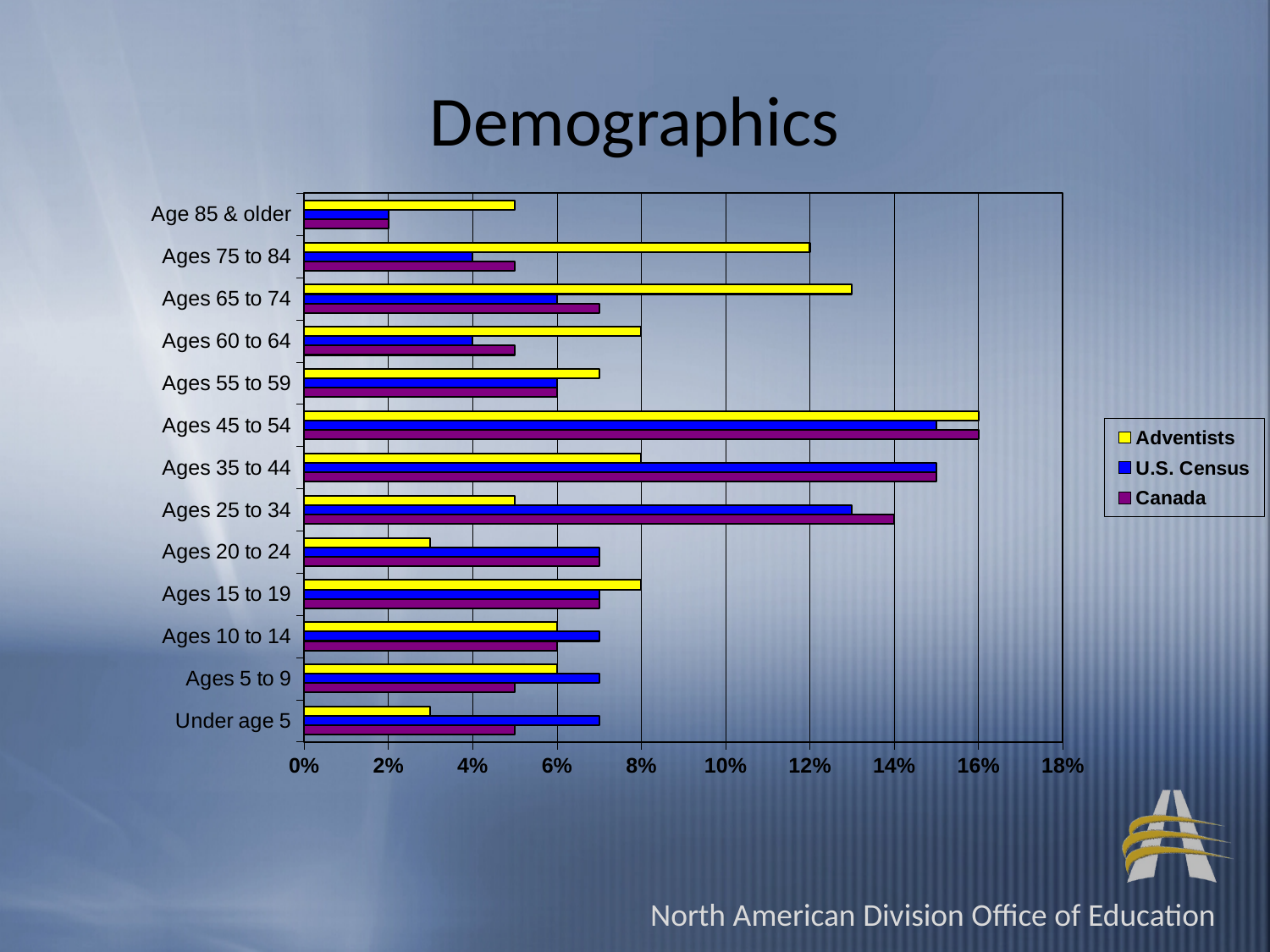
Which age category has the highest Canada value? Ages 45 to 54 Which age category has the highest Adventists value? Ages 45 to 54 What is the Adventists value for Ages 75 to 84? 12% Is the Adventists value for Ages 65 to 74 greater or less than 12%? greater What kind of chart is shown on the slide? bar chart For Ages 35 to 44, which is larger: the Adventists value or the U.S. Census value? U.S. Census What is the Adventists value for Ages 45 to 54? 16% Which colour represents the Adventists series? yellow Is the U.S. Census value for Ages 75 to 84 greater or less than 6%? less What is the title of the chart? Demographics How many age categories are shown on the chart? 13 How many series does the legend list? 3